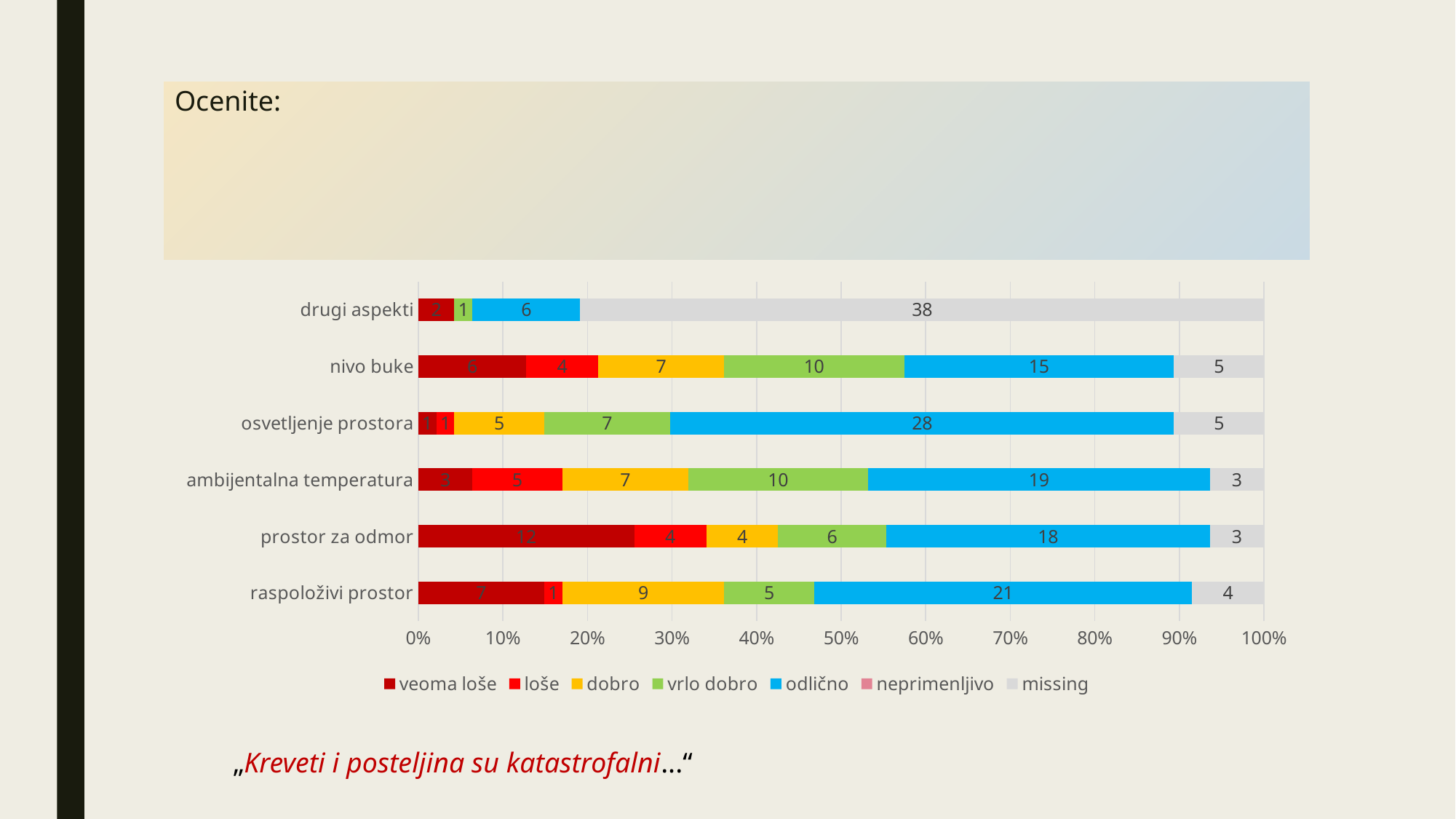
Which is larger: the "veoma loše" value for "nivo buke" or for "raspoloživi prostor"? raspoloživi prostor What is the value of the "odlično" segment for "osvetljenje prostora"? 28 How many categories are shown on the y axis? 6 What is the value of the "vrlo dobro" segment for "nivo buke"? 10 What is the total of all segments in the "nivo buke" bar? 47 How many series does the legend list? 7 What is the value of the "veoma loše" segment for "prostor za odmor"? 12 Which category has the lowest "odlično" value? drugi aspekti What is the difference between the "odlično" values for "raspoloživi prostor" and "prostor za odmor"? 3 What is the value of the "missing" segment for "drugi aspekti"? 38 Which category has the highest "odlično" value? osvetljenje prostora What kind of chart is shown on the slide? stacked bar chart